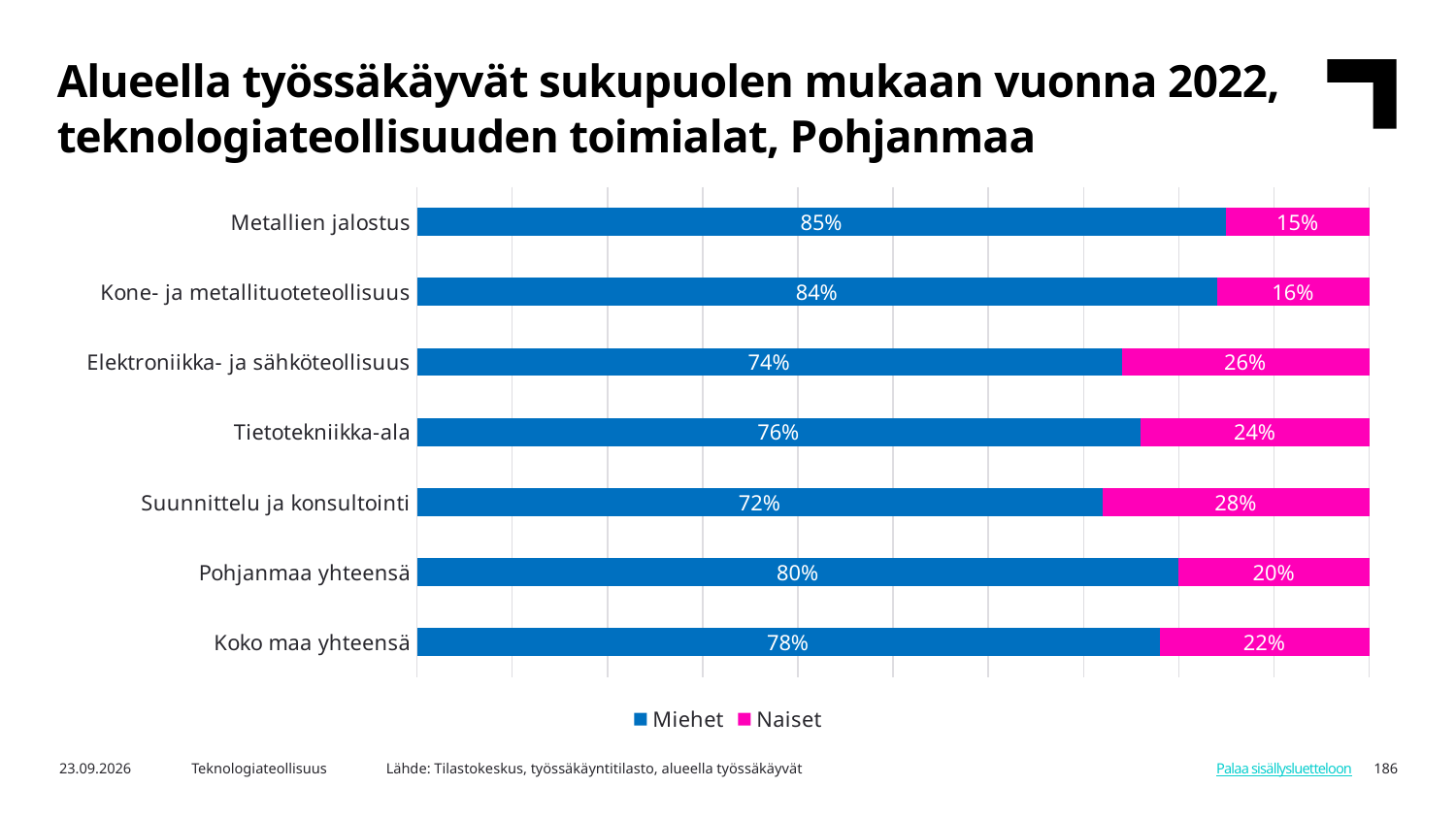
How many series does the legend list? 2 What is the difference between the Miehet share for Pohjanmaa yhteensä and Koko maa yhteensä? 2 percentage points Which category has the highest Miehet share? Metallien jalostus What is the Naiset share for Suunnittelu ja konsultointi? 28% What is the Miehet share for Koko maa yhteensä? 78% What is the Miehet share for Metallien jalostus? 85% What is the Naiset share for Tietotekniikka-ala? 24% Which has a larger Naiset share: Elektroniikka- ja sähköteollisuus or Kone- ja metallituoteteollisuus? Elektroniikka- ja sähköteollisuus What kind of chart is shown on the slide? Stacked bar chart Which category has the highest Naiset share? Suunnittelu ja konsultointi Which category has the lowest Miehet share? Suunnittelu ja konsultointi How many categories are shown on the chart? 7